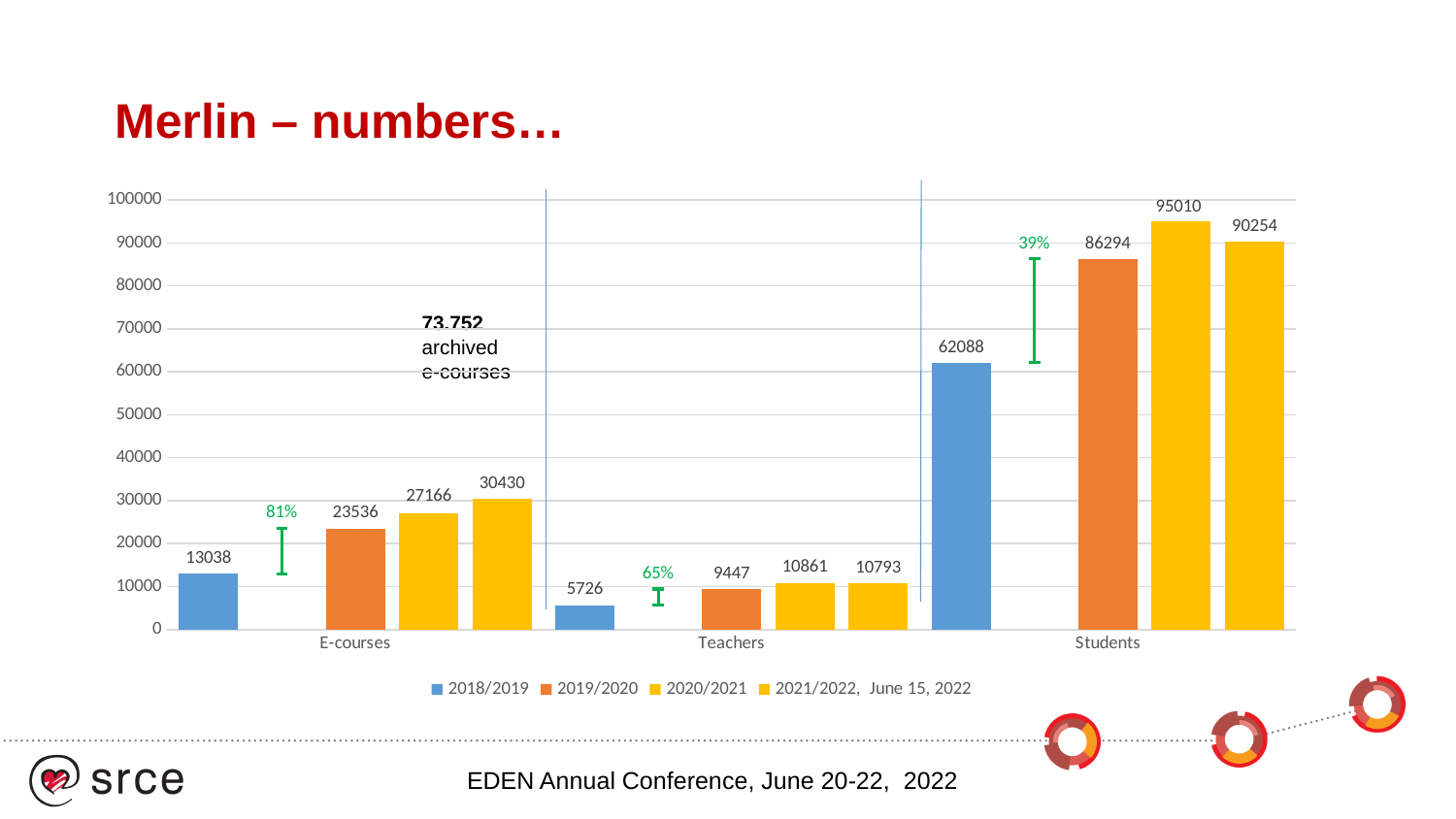
How many categories are shown on the x axis? 3 What is the value for Teachers in 2019/2020? 9447 What kind of chart is shown on the slide? bar chart Which category has the lowest value in 2020/2021? Teachers Is the value for Students in 2018/2019 greater or less than 60000? greater What is the difference between the Students values for 2020/2021 and 2019/2020? 8716 What is the value for Students in 2021/2022? 90254 What is the value for E-courses in 2018/2019? 13038 Which is larger for Teachers: the 2020/2021 value or the 2021/2022 value? 2020/2021 What is the value for Students in 2020/2021? 95010 How many series does the legend list? 4 Which category has the highest value in 2018/2019? Students